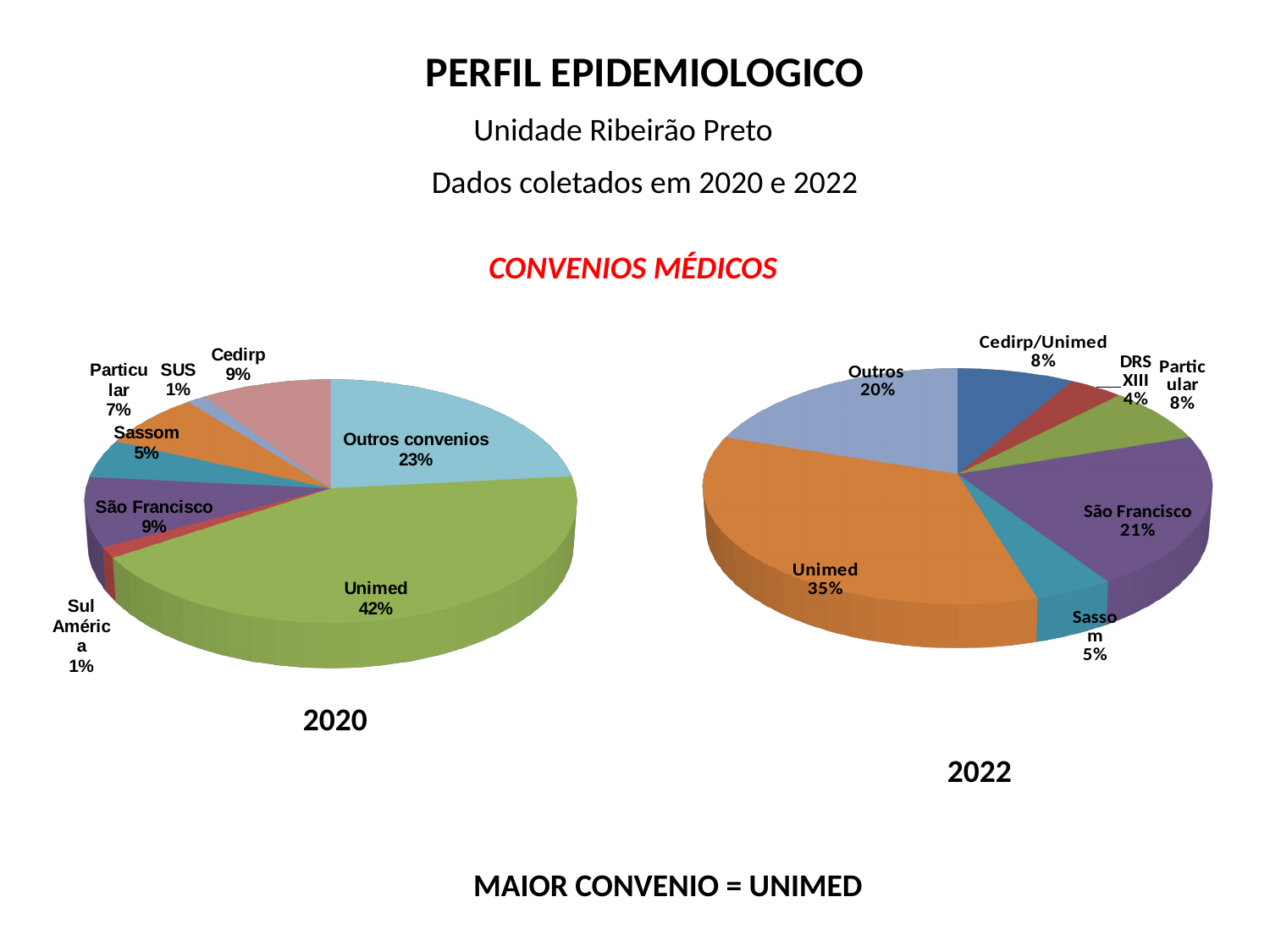
In the 2022 pie chart, what is the difference between the Unimed share and the São Francisco share? 14% In the 2020 pie chart, which category has the largest share? Unimed In the 2020 pie chart, which is larger, the share for Particular or the share for Sassom? Particular In the 2022 pie chart, what share does São Francisco have? 21% How many slices does the 2022 pie chart have? 7 In the 2022 pie chart, which category has the smallest share? DRS XIII What type of chart is used for the 2022 data? Pie chart How many slices does the 2020 pie chart have? 8 What is the red subtitle above the two charts? CONVENIOS MÉDICOS In the 2022 pie chart, what share does Outros have? 20% In the 2020 pie chart, what share does Unimed have? 42% In the 2020 pie chart, what share does Outros convenios have? 23%